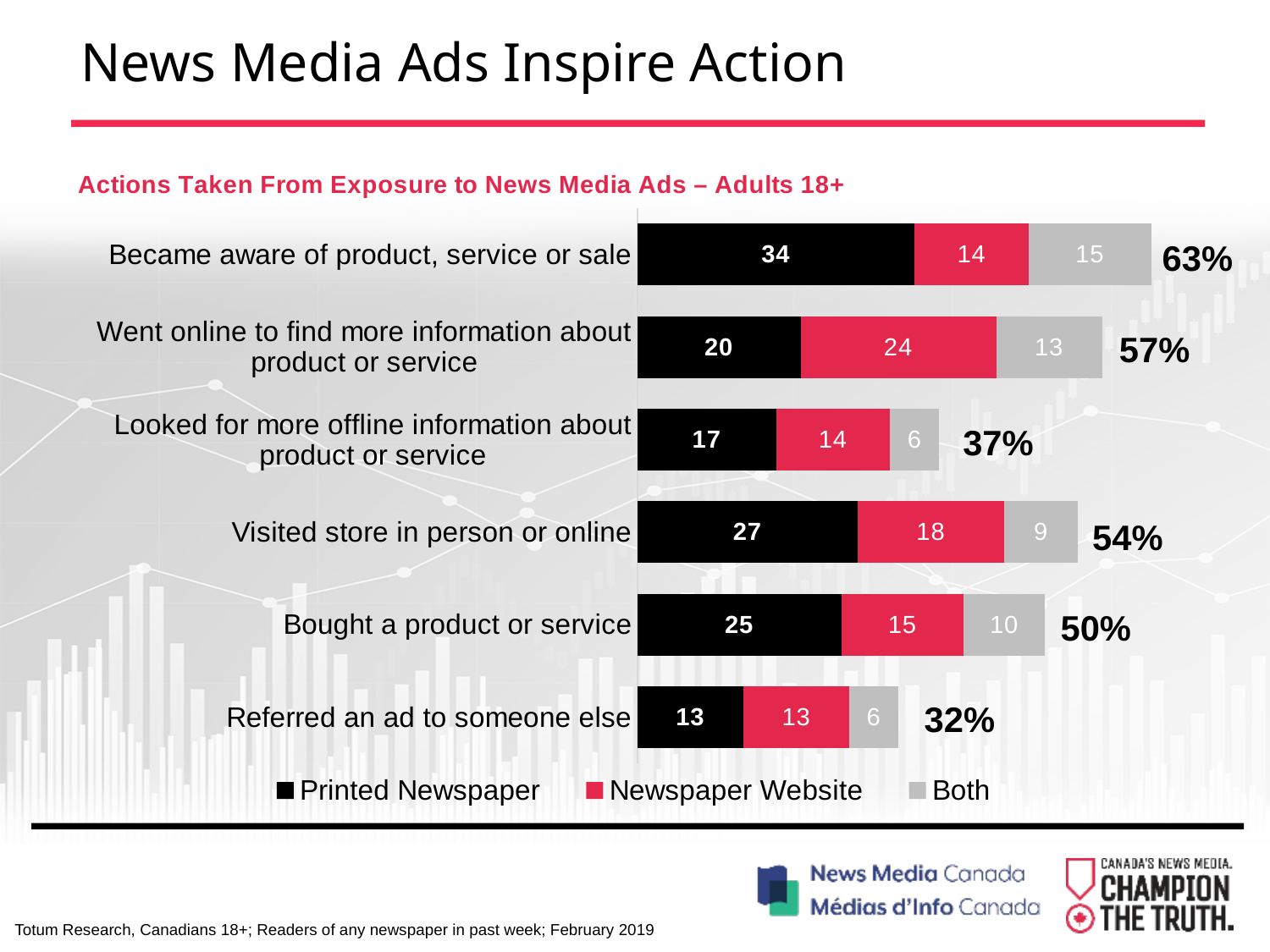
How many series does the legend list? 3 What is the difference between the Printed Newspaper values for "Became aware of product, service or sale" and "Referred an ad to someone else"? 21 Which series is shown in black in the chart? Printed Newspaper What is the total shown for "Visited store in person or online"? 54% What kind of chart is shown on the slide? Stacked bar chart Which is larger for "Went online to find more information about product or service": the Printed Newspaper value or the Newspaper Website value? Newspaper Website How many actions (categories) are shown in the chart? 6 What is the Printed Newspaper value for "Became aware of product, service or sale"? 34 What is the Newspaper Website value for "Went online to find more information about product or service"? 24 Which action has the lowest total percentage? Referred an ad to someone else What is the Both value for "Bought a product or service"? 10 Which action has the highest total percentage? Became aware of product, service or sale